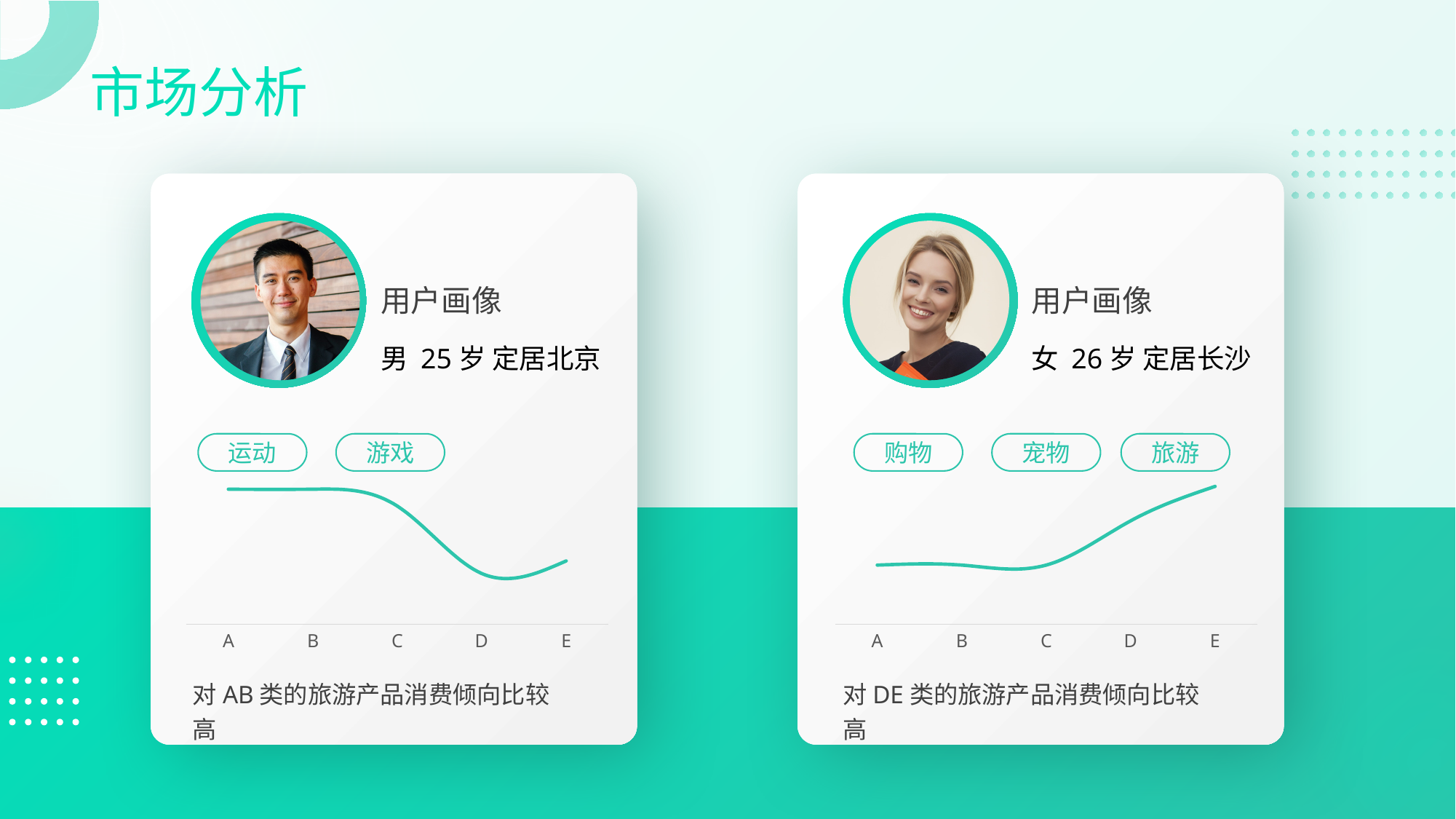
In the right chart, which category has the highest value? E In the right chart, which is larger, the value for B or the value for D? D What kind of chart is shown on the left card (the male user profile)? line chart In the right chart, do the values generally rise or fall from A to E? rise In the left chart, which category has the lowest value? D In the right chart, which is larger, the value for A or the value for E? E What are the x-axis category labels on the left chart? A, B, C, D, E How many categories are on the x axis of the right chart? 5 What kind of chart is shown on the right card (the female user profile)? line chart In the left chart, do the values generally rise or fall from A to E? fall How many categories are on the x axis of the left chart? 5 In the left chart, which is larger, the value for A or the value for D? A